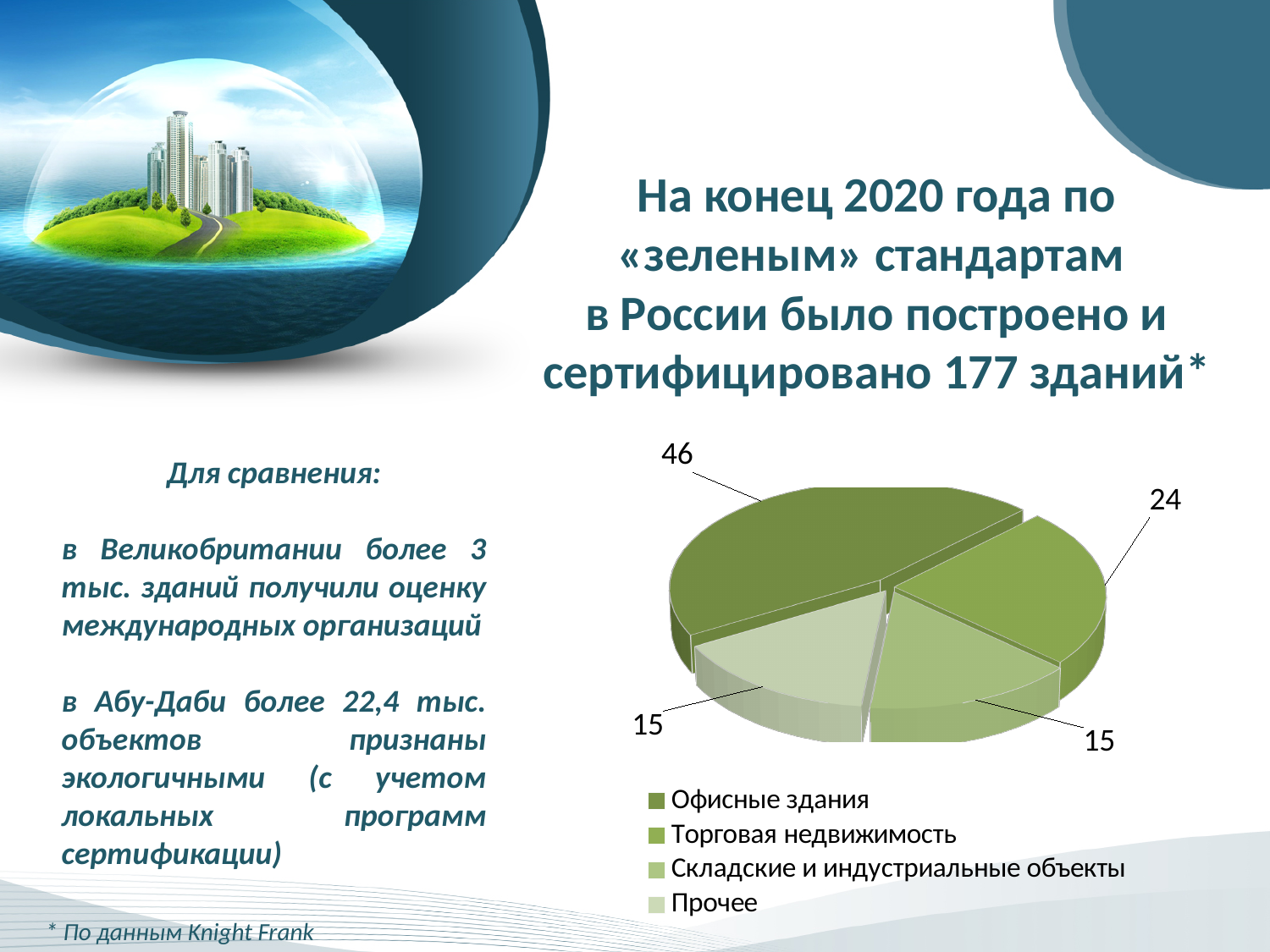
Which legend entry is shown in the darkest green colour? Офисные здания What value is shown for the Прочее slice of the pie chart? 15 How many entries does the chart legend list? 4 What kind of chart is shown on the slide? Pie chart What value is shown for the Складские и индустриальные объекты slice of the pie chart? 15 Which is larger: the value for Торговая недвижимость or the value for Прочее? Торговая недвижимость How many slices does the pie chart have? 4 Which category has the largest slice in the pie chart? Офисные здания What value is shown for the Офисные здания slice of the pie chart? 46 What is the difference between the values for Офисные здания and Торговая недвижимость? 22 What value is shown for the Торговая недвижимость slice of the pie chart? 24 What is the total of all the values labelled on the pie chart? 100